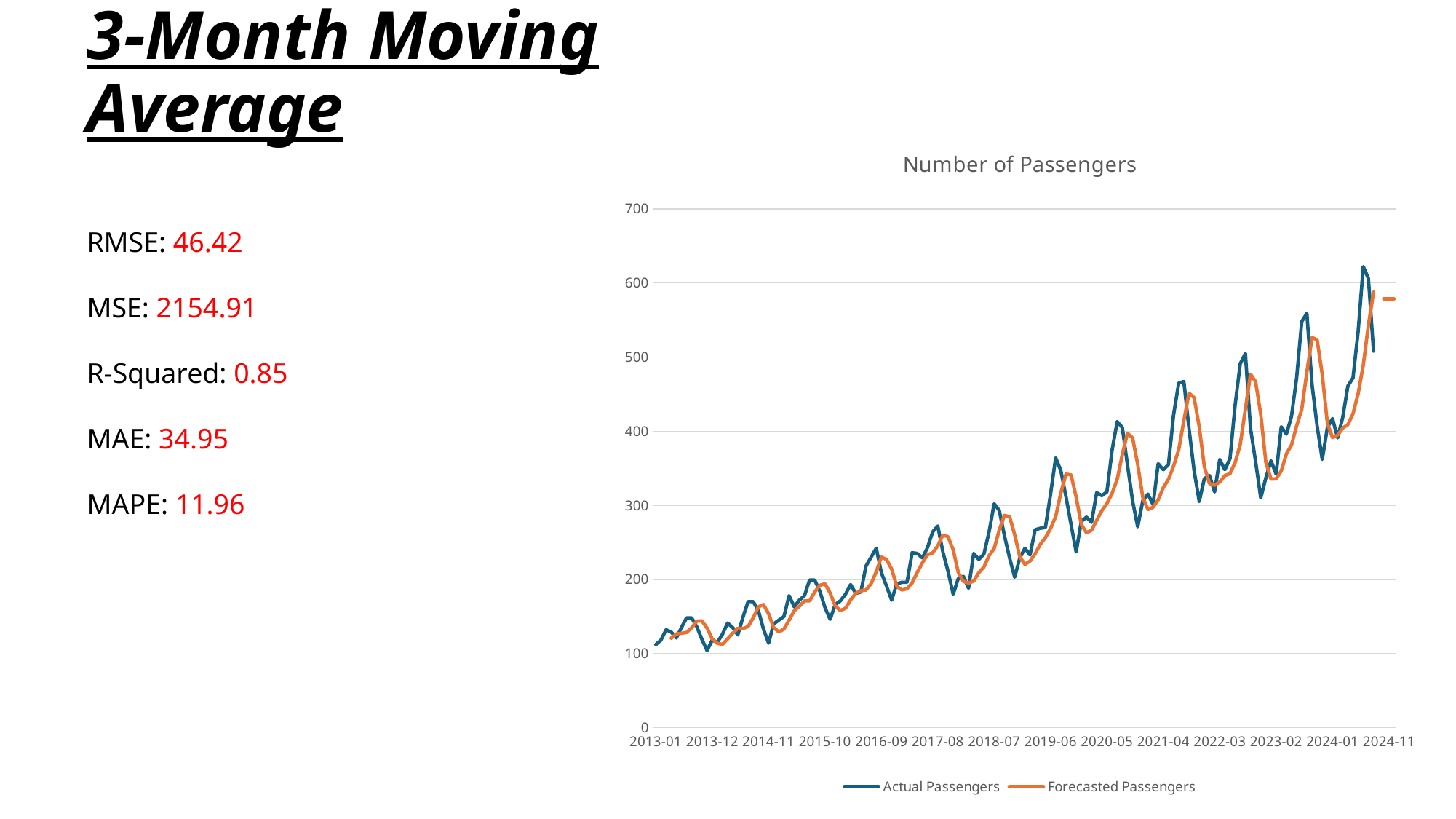
Is the highest value reached by the Actual Passengers series greater or less than 600? greater Is the highest value reached by the Forecasted Passengers series greater or less than 600? less How many series does the legend of the Number of Passengers chart list? 2 What kind of chart is shown on the slide? line chart Which series in the Number of Passengers chart is drawn in orange? Forecasted Passengers Do the Actual Passengers values generally rise or fall from 2013-01 to 2024-11? rise What is the title of the chart on the slide? Number of Passengers Which series reaches the higher peak value in the Number of Passengers chart, Actual Passengers or Forecasted Passengers? Actual Passengers Is the last value of the Forecasted Passengers series greater or less than 500? greater How many date labels are shown on the x axis of the Number of Passengers chart? 14 What is the highest value labelled on the y axis of the Number of Passengers chart? 700